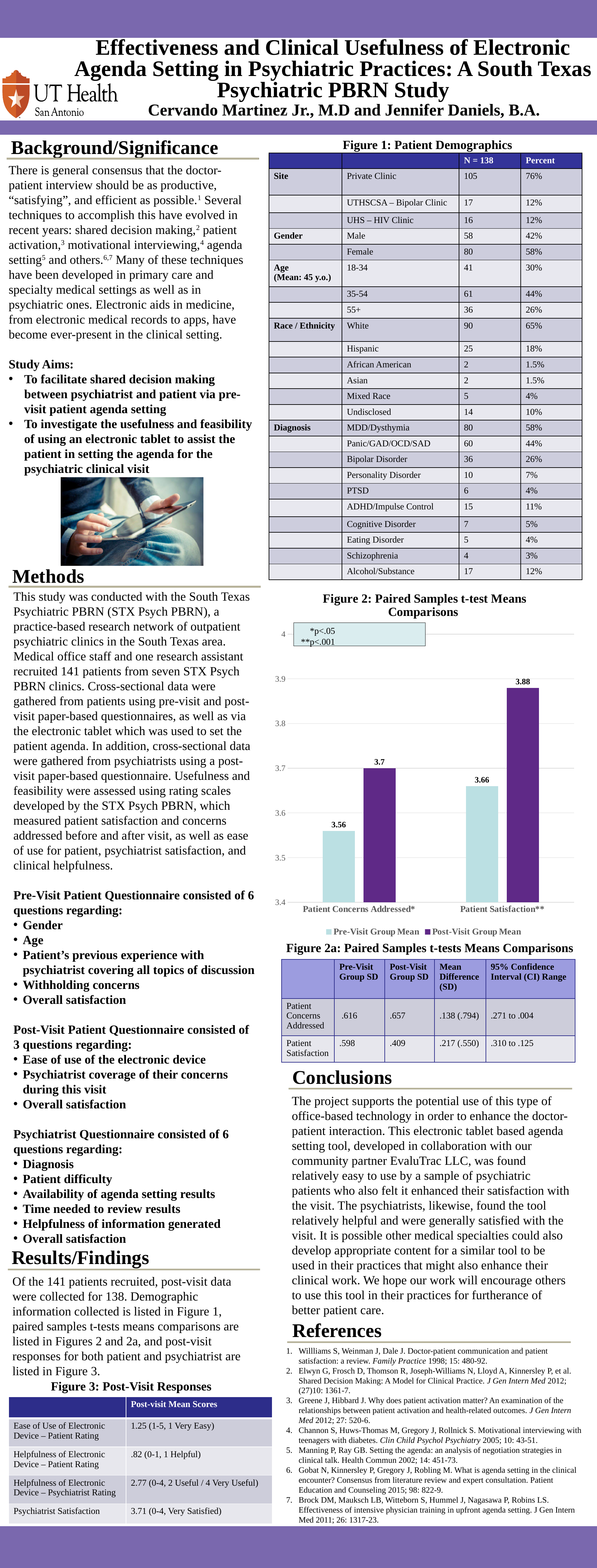
In Figure 2, what is the difference between the Post-Visit and Pre-Visit Group Means for Patient Concerns Addressed*? 0.14 In Figure 2, which is larger: the Pre-Visit Group Mean for Patient Satisfaction** or the Post-Visit Group Mean for Patient Concerns Addressed*? Post-Visit Group Mean for Patient Concerns Addressed* In Figure 2, what is the difference between the Post-Visit and Pre-Visit Group Means for Patient Satisfaction**? 0.22 How many categories are shown on the x axis of Figure 2? 2 In Figure 2, what is the Pre-Visit Group Mean for Patient Satisfaction**? 3.66 In Figure 2, which bar has the lowest value? Pre-Visit Group Mean for Patient Concerns Addressed* In Figure 2, what is the Pre-Visit Group Mean for Patient Concerns Addressed*? 3.56 In Figure 2, what is the Post-Visit Group Mean for Patient Satisfaction**? 3.88 What kind of chart is Figure 2? Bar chart In Figure 2, what is the Post-Visit Group Mean for Patient Concerns Addressed*? 3.7 How many series does the legend of Figure 2 list? 2 In Figure 2, which bar has the highest value? Post-Visit Group Mean for Patient Satisfaction**